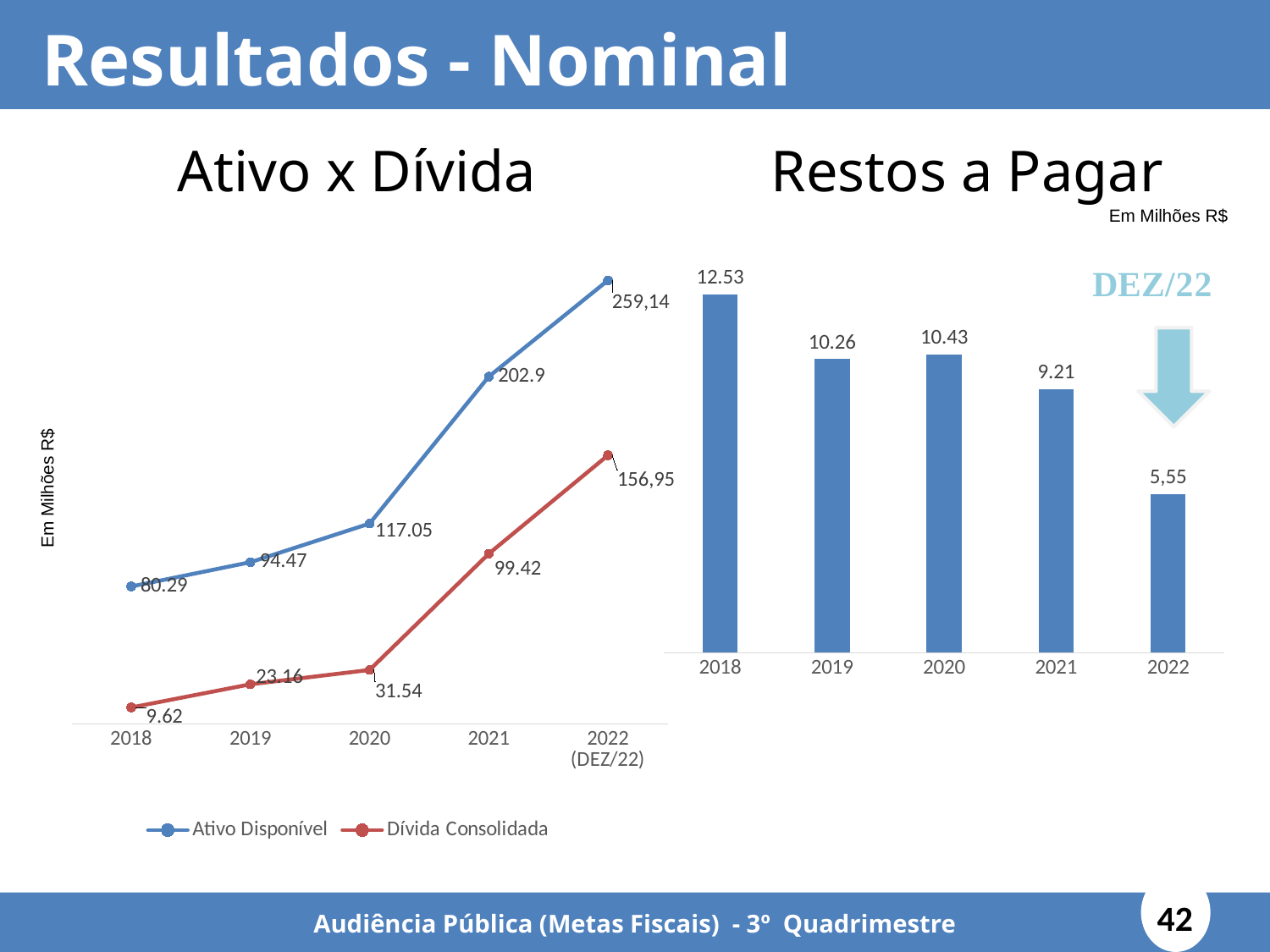
In the 'Ativo x Dívida' chart, what is the difference between Ativo Disponível and Dívida Consolidada in 2022 (DEZ/22)? 102,19 In the 'Ativo x Dívida' chart, what is the value of Dívida Consolidada in 2021? 99.42 In the 'Restos a Pagar' chart, how many years are shown? 5 In the 'Ativo x Dívida' chart, what is the value of Ativo Disponível in 2020? 117.05 In the 'Ativo x Dívida' chart, what is the value of Dívida Consolidada in 2018? 9.62 In the 'Restos a Pagar' chart, which year has the lowest value? 2022 In the 'Restos a Pagar' chart, what is the difference between the 2018 and 2022 values? 6.98 In the 'Ativo x Dívida' chart, does Ativo Disponível rise or fall from 2018 to 2022? Rise In the 'Restos a Pagar' chart, what is the value for 2019? 10.26 In the 'Ativo x Dívida' chart, what kind of chart is it? Line chart In the 'Ativo x Dívida' chart, how many series does the legend list? 2 In the 'Restos a Pagar' chart, which year has the highest value? 2018